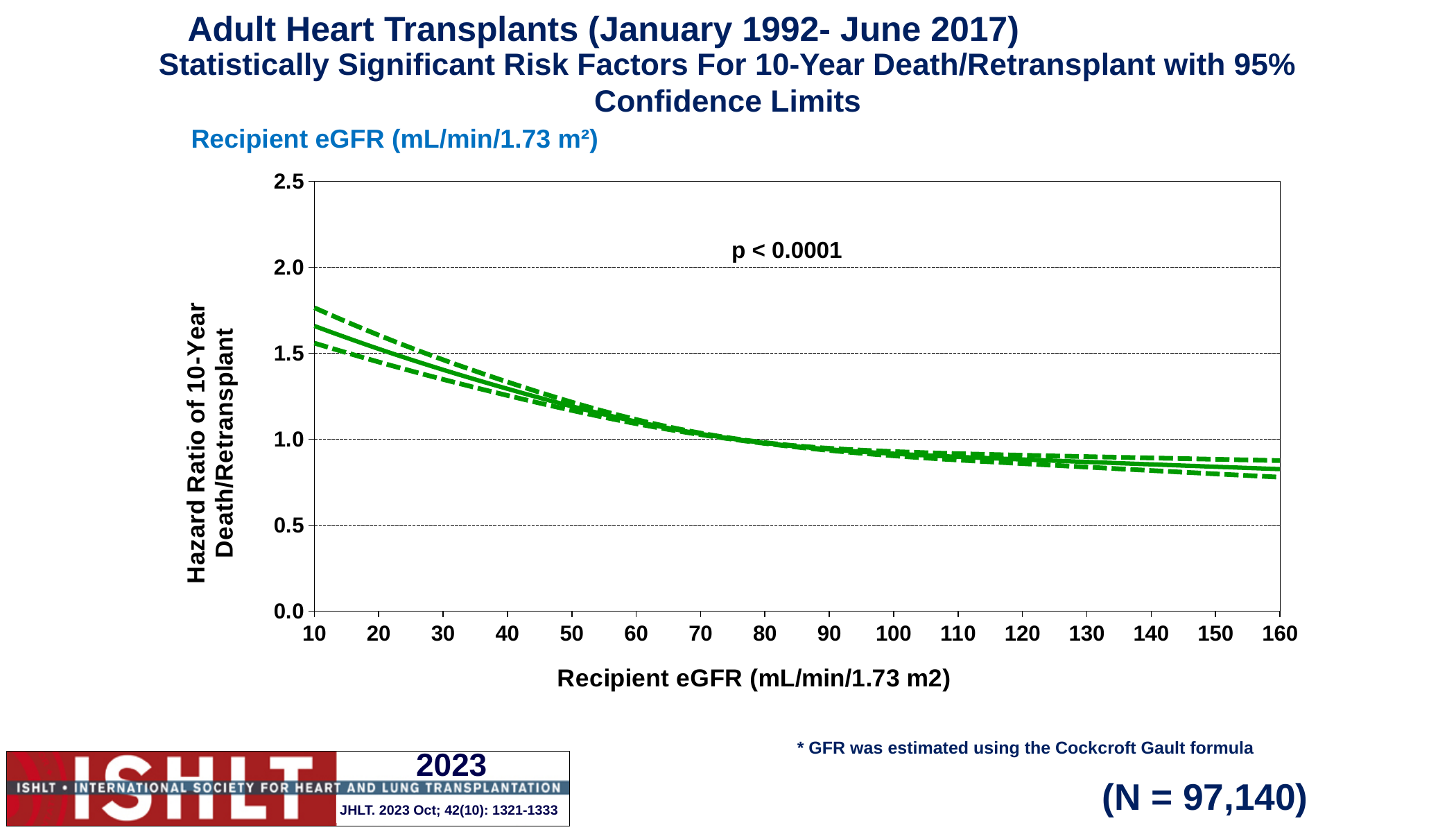
Which has the higher hazard ratio, a recipient eGFR of 20 or a recipient eGFR of 120? 20 Does the hazard ratio rise or fall as recipient eGFR increases along the x axis? fall What is the highest value shown on the y axis of the chart? 2.5 How many lines are plotted on the chart, including the confidence limit lines? 3 What kind of chart is shown on the slide? line chart Is the hazard ratio at a recipient eGFR of 10 greater or less than 2.0? less Is the hazard ratio at a recipient eGFR of 160 greater or less than 1.0? less Is the hazard ratio at a recipient eGFR of 10 greater or less than 1.5? greater What p-value is printed on the chart? p < 0.0001